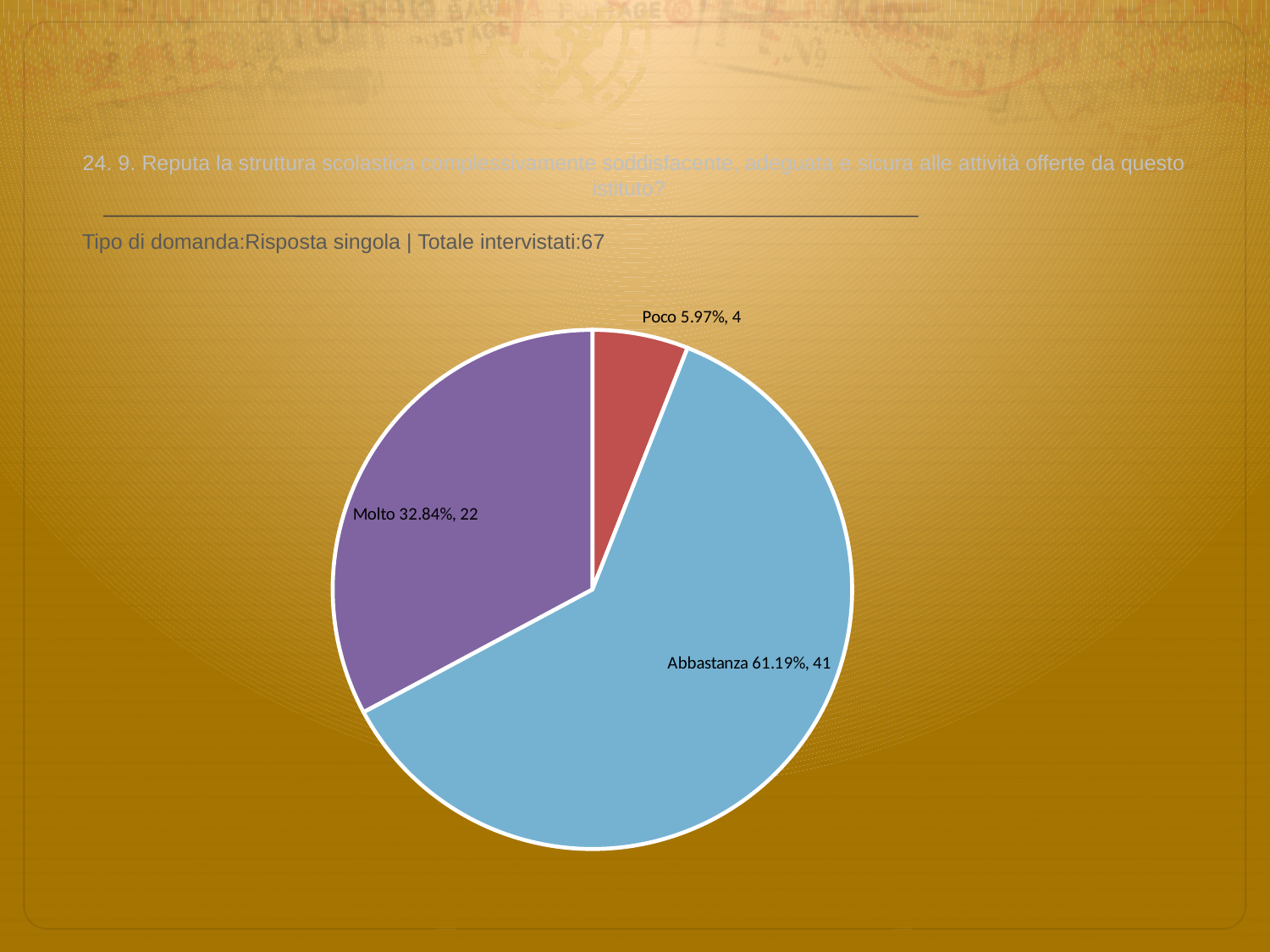
Which slice is larger, Molto or Poco? Molto What is the difference in respondent count between Abbastanza and Molto? 19 What percentage share does the Molto slice have? 32.84% How many respondents answered Abbastanza? 41 What kind of chart is shown on the slide? pie chart Which category has the largest slice of the pie? Abbastanza How many respondents answered Poco? 4 How many respondents answered Molto? 22 What percentage share does the Poco slice have? 5.97% How many slices does the pie chart have? 3 What percentage share does the Abbastanza slice have? 61.19% Which category has the smallest slice of the pie? Poco